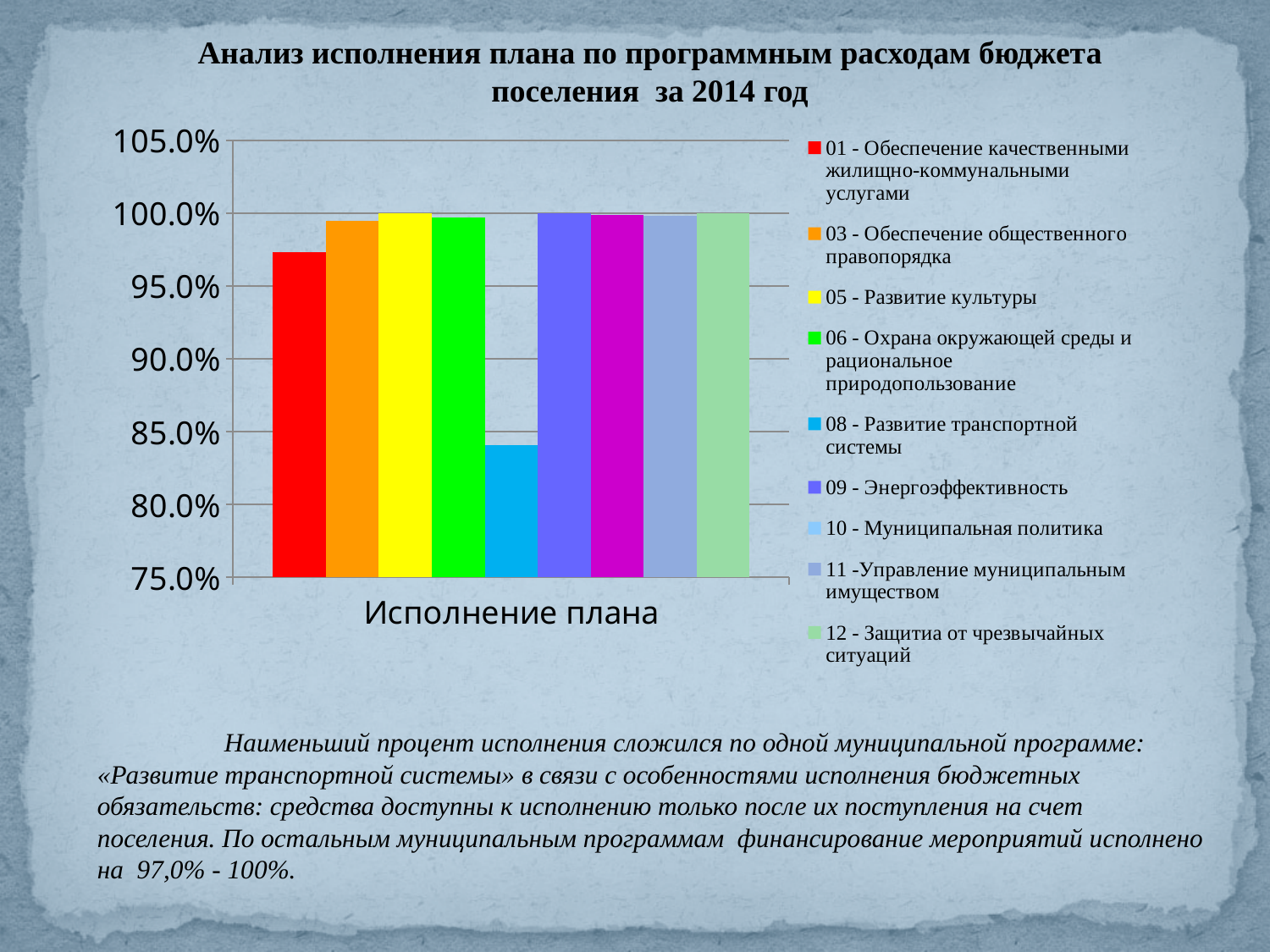
Is the value for 08 - Развитие транспортной системы greater or less than 85.0%? less Is the value for 03 - Обеспечение общественного правопорядка greater or less than 95.0%? greater How many series does the legend list? 9 Which series has the lowest value? 08 - Развитие транспортной системы What kind of chart is shown on the slide? bar chart Is the value for 08 - Развитие транспортной системы greater or less than 80.0%? greater What colour is the bar for 08 - Развитие транспортной системы? blue Which is larger, the value for 01 - Обеспечение качественными жилищно-коммунальными услугами or the value for 08 - Развитие транспортной системы? 01 - Обеспечение качественными жилищно-коммунальными услугами What is the category label shown on the x axis? Исполнение плана How many categories are shown on the x axis? 1